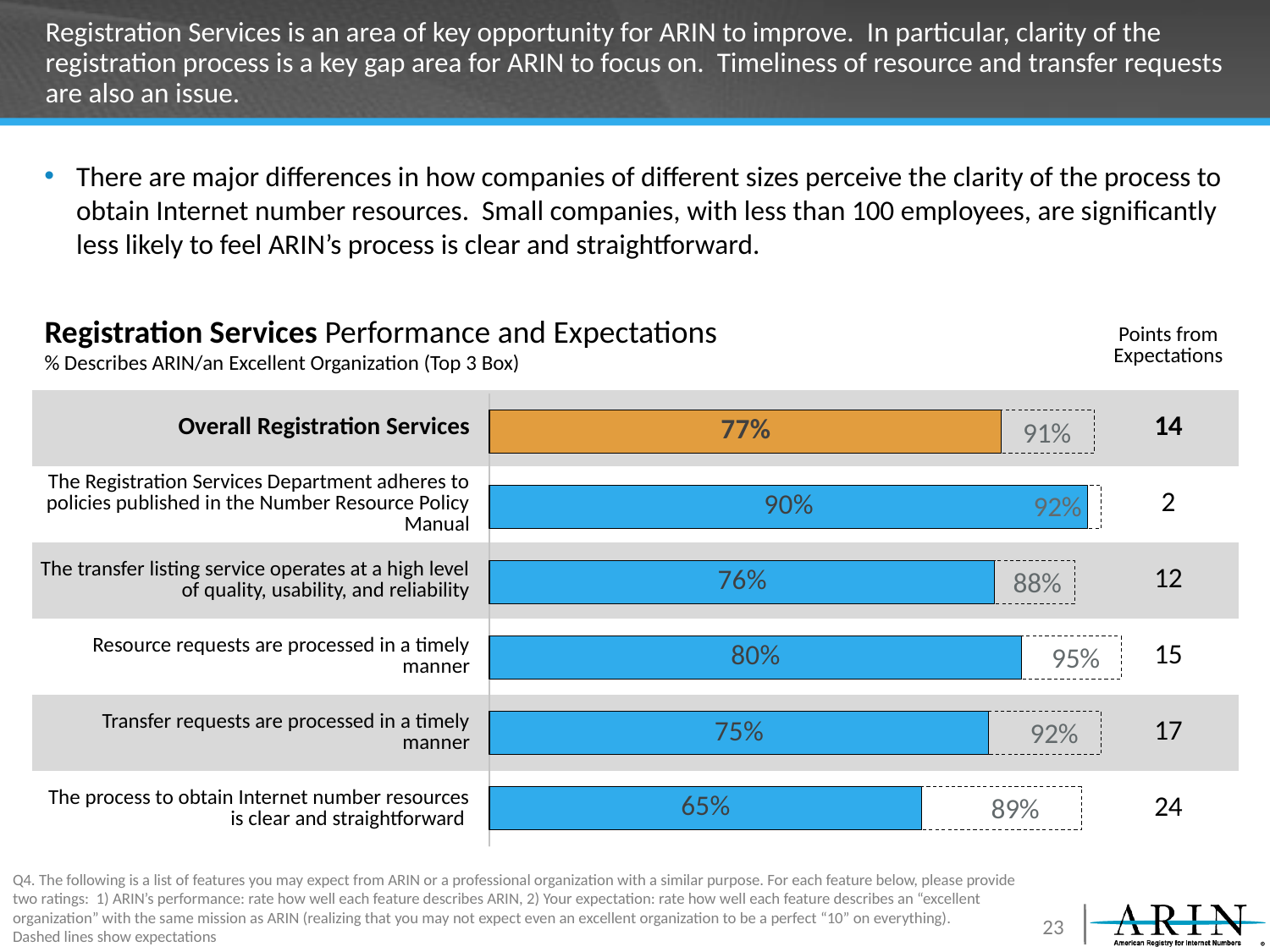
What is the "Points from Expectations" value for "The process to obtain Internet number resources is clear and straightforward"? 24 What is the difference between the expectation and performance values for "Transfer requests are processed in a timely manner"? 17 Which category has the smallest gap between performance and expectations? The Registration Services Department adheres to policies published in the Number Resource Policy Manual What is the title of the chart? Registration Services Performance and Expectations What is the performance value for "The process to obtain Internet number resources is clear and straightforward"? 65% Which category has the lowest performance value? The process to obtain Internet number resources is clear and straightforward What is the expectation value (dashed bar) for "Resource requests are processed in a timely manner"? 95% How many categories are shown in the chart? 6 What kind of chart is shown on the slide? Bar chart Which is larger: the performance value for "Resource requests are processed in a timely manner" or for "The transfer listing service operates at a high level of quality, usability, and reliability"? Resource requests are processed in a timely manner What is the performance value for "Overall Registration Services"? 77% Which category has the highest performance value? The Registration Services Department adheres to policies published in the Number Resource Policy Manual